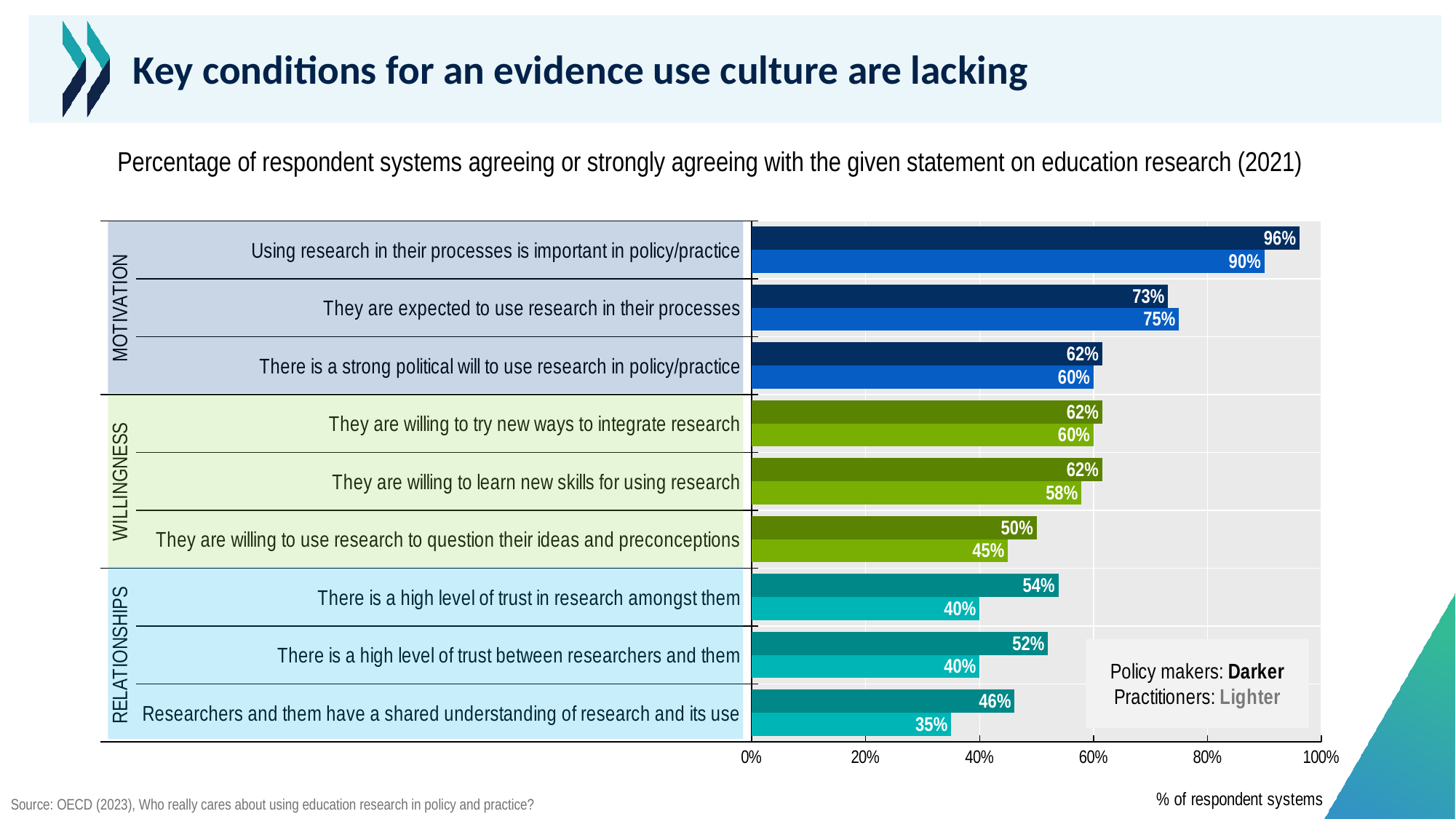
How many statements are shown in the chart? 9 Which colour shade represents policy makers in the chart? Darker What is the difference between the policy makers' and practitioners' values for 'There is a high level of trust in research amongst them'? 14% What is the practitioners' value for 'Researchers and them have a shared understanding of research and its use'? 35% What percentage of practitioners agree that they are expected to use research in their processes? 75% How many respondent groups does the chart compare? 2 What percentage of policy makers agree that using research in their processes is important in policy/practice? 96% For 'They are expected to use research in their processes', which group has the larger value, policy makers or practitioners? Practitioners Which statement has the lowest value for practitioners? Researchers and them have a shared understanding of research and its use What type of chart is shown on the slide? Bar chart What are the three category groups labelled on the left of the chart? Motivation, Willingness, Relationships Which statement has the highest value for policy makers? Using research in their processes is important in policy/practice